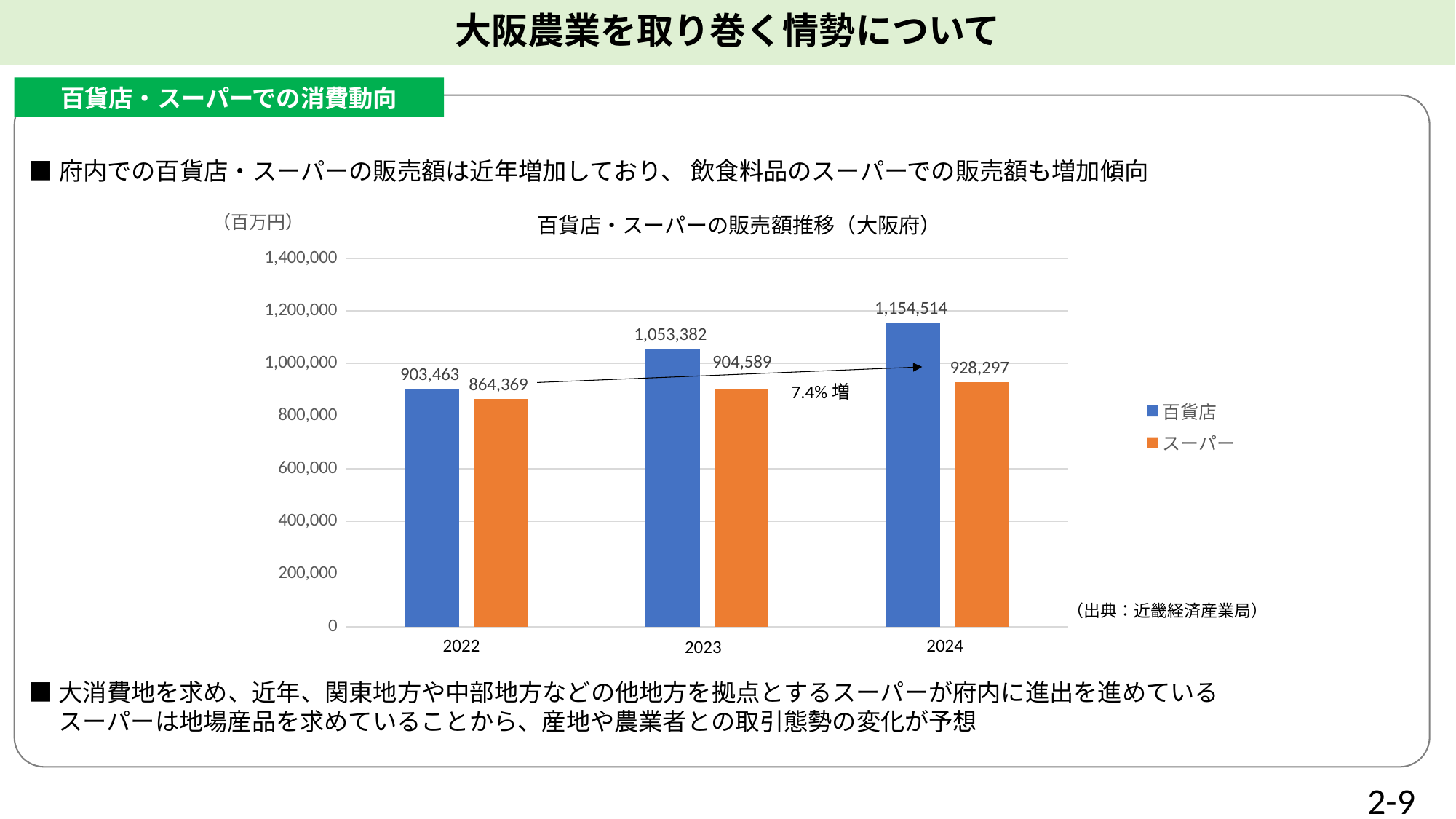
What is the value for 百貨店 in 2024? 1,154,514 In which year is the スーパー value lowest? 2022 What is the value for スーパー in 2022? 864,369 What is the difference between the 百貨店 and スーパー values in 2024? 226,217 In which year is the 百貨店 value highest? 2024 Which is larger in 2023, the 百貨店 value or the スーパー value? 百貨店 What is the difference between the 百貨店 value in 2024 and in 2022? 251,051 How many years are shown on the x axis? 3 Do the 百貨店 values rise or fall from 2022 to 2024? rise How many series does the legend list? 2 What is the value for スーパー in 2023? 904,589 What kind of chart is shown? bar chart